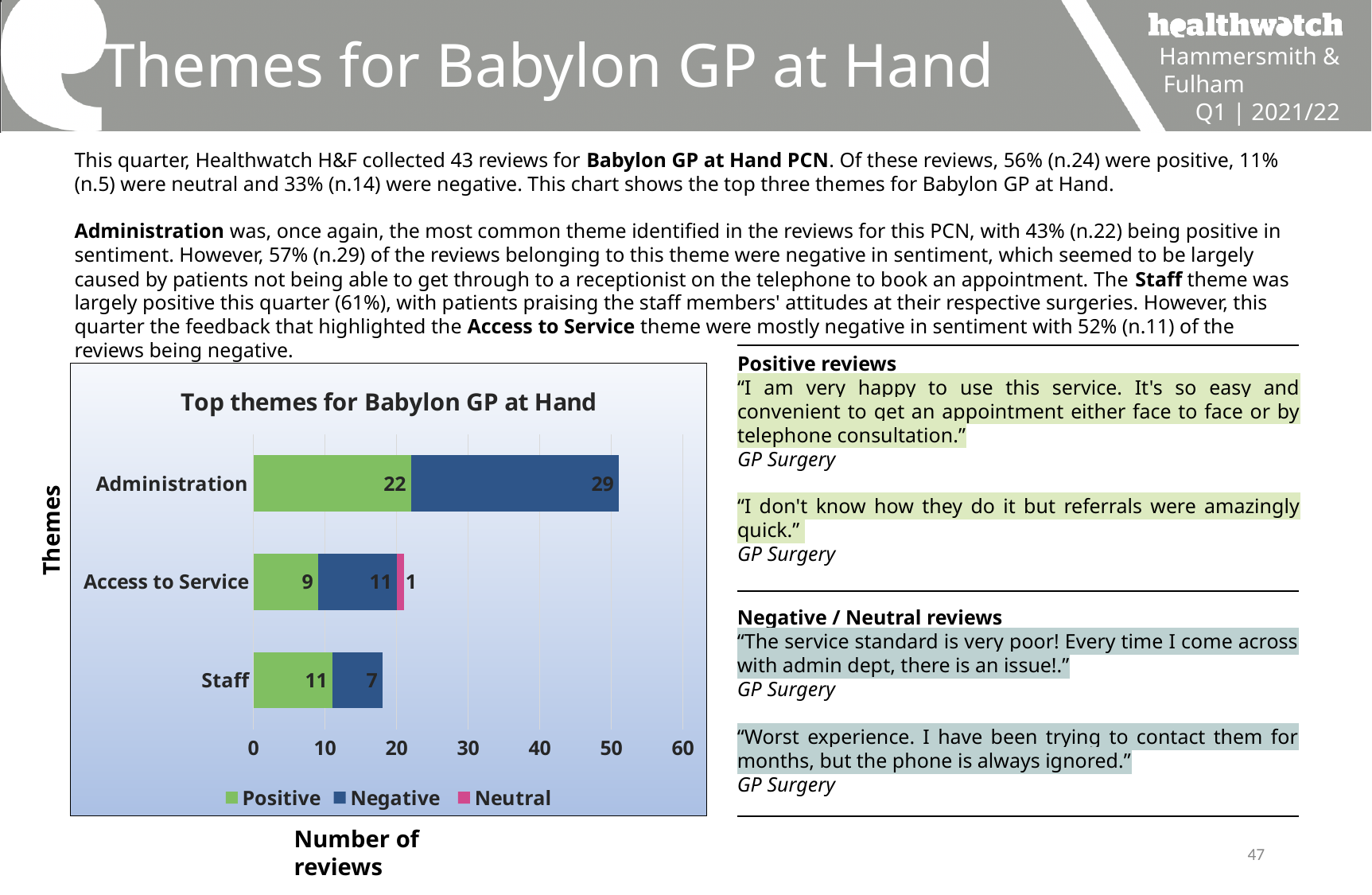
What is the total number of reviews for the Access to Service bar? 21 What is the Negative value for Access to Service? 11 How many series does the legend list? 3 Which theme has the lowest Positive value? Access to Service What is the Positive value for Administration? 22 What is the Negative value for Staff? 7 How many themes are shown on the chart? 3 What is the difference between the Negative and Positive values for Administration? 7 What kind of chart is shown? Stacked bar chart Which theme has the highest Negative value? Administration Which is larger for Staff, the Positive value or the Negative value? Positive What is the Neutral value for Access to Service? 1